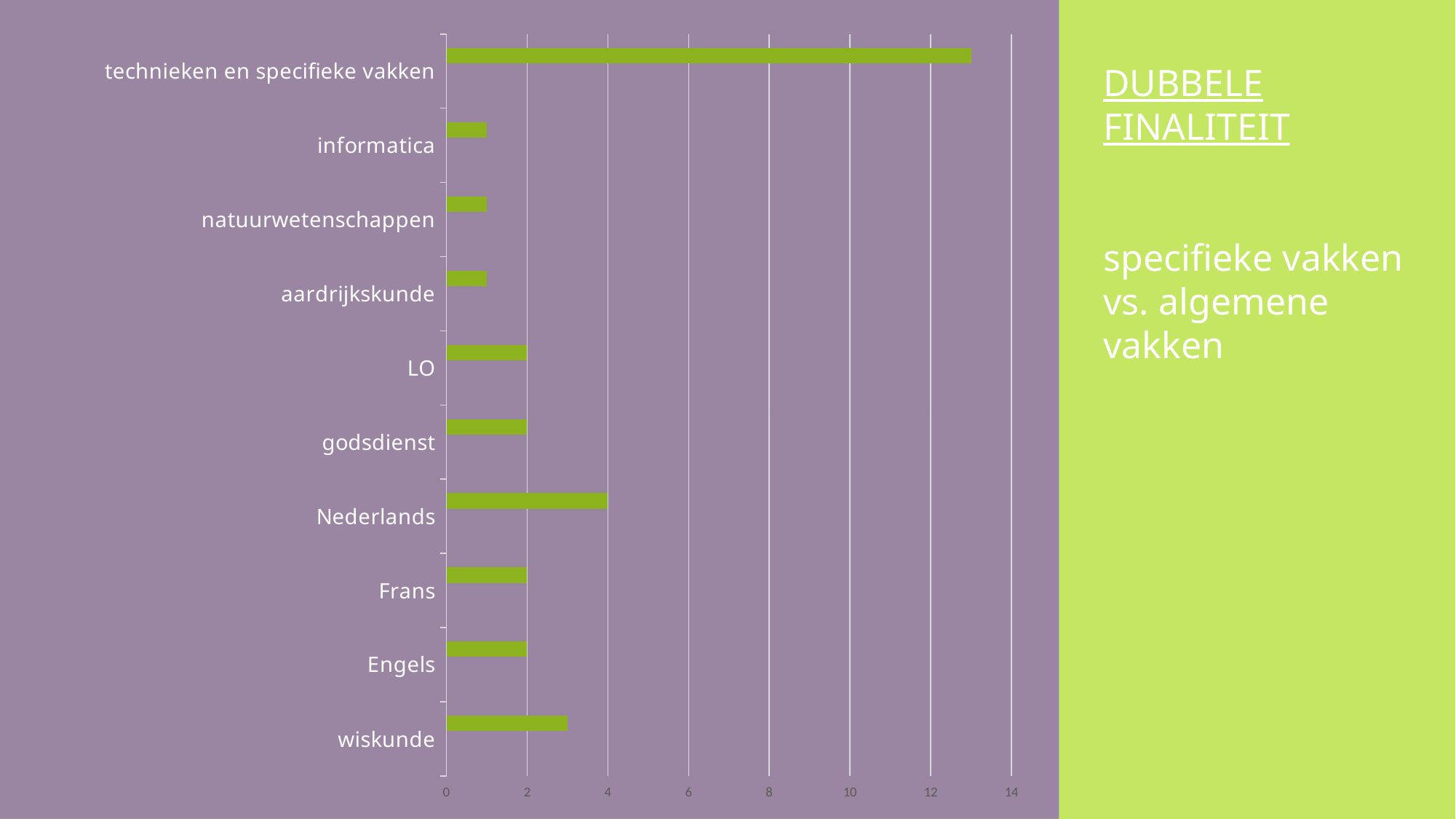
What kind of chart is shown on the slide? bar chart What is the value for Frans? 2 What is the value for LO? 2 Which is larger, the value for Nederlands or the value for Engels? Nederlands What is the difference between the values for Nederlands and godsdienst? 2 Which category has the highest value in the chart? technieken en specifieke vakken Is the value for informatica greater or less than 2? less What is the highest value shown on the horizontal axis? 14 Is the value for wiskunde greater or less than 2? greater How many categories are plotted in the chart? 10 What is the value for Nederlands? 4 Is the value for technieken en specifieke vakken greater or less than 12? greater